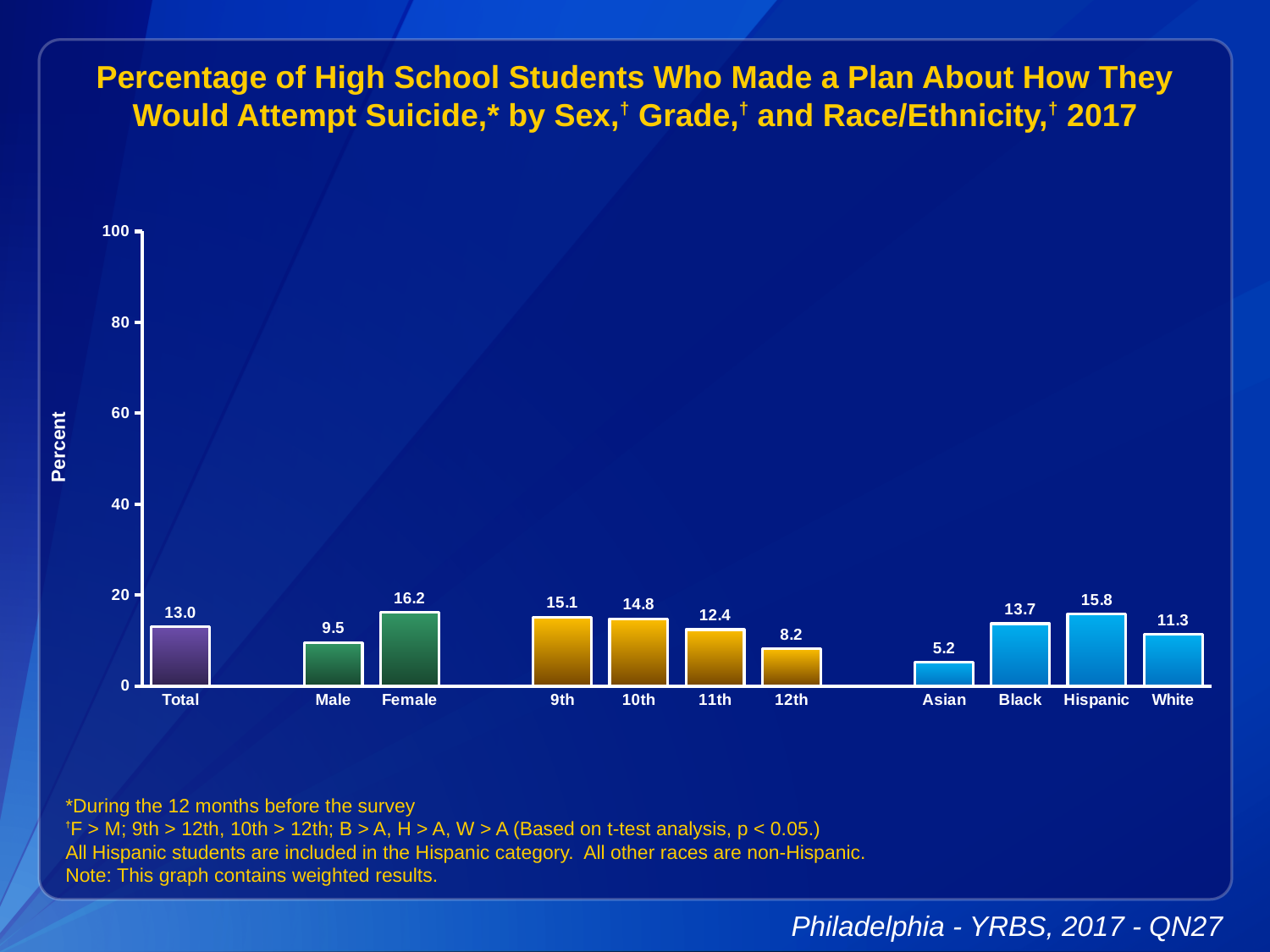
What is the label of the y axis? Percent How many bars are shown in the chart? 11 Which is larger, the value for Hispanic or the value for White? Hispanic Is the value for 9th grade greater or less than 20? less Which category has the highest value? Female What kind of chart is shown on the slide? bar chart What is the value for Total? 13.0 Which category has the lowest value? Asian What is the difference between the Female and Male values? 6.7 What is the value for 12th grade? 8.2 What is the value for Female? 16.2 What is the value for Asian students? 5.2